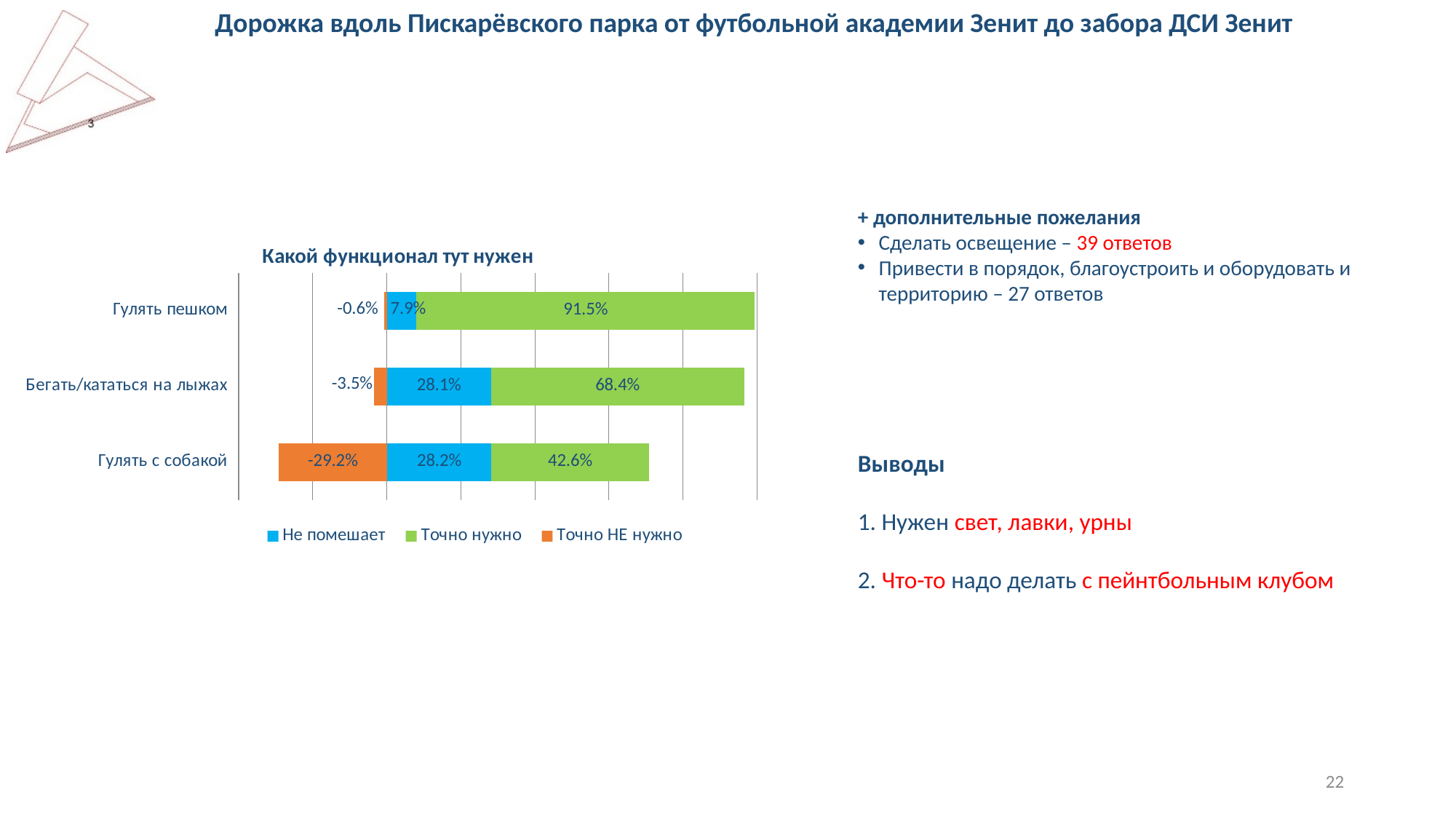
What is the title of the chart? Какой функционал тут нужен What is the value of "Точно НЕ нужно" for "Гулять пешком"? -0.6% What kind of chart is shown on the slide? Stacked bar chart How many series does the legend list? 3 What is the value of "Точно нужно" for "Гулять пешком"? 91.5% Which category has the highest value for "Точно нужно"? Гулять пешком How many categories does the chart show? 3 Which is larger: the "Точно нужно" value for "Бегать/кататься на лыжах" or for "Гулять с собакой"? Бегать/кататься на лыжах What is the value of "Точно НЕ нужно" for "Гулять с собакой"? -29.2% What is the difference between the "Точно нужно" values for "Гулять пешком" and "Гулять с собакой"? 48.9% Which category has the lowest value for "Не помешает"? Гулять пешком What is the value of "Не помешает" for "Бегать/кататься на лыжах"? 28.1%